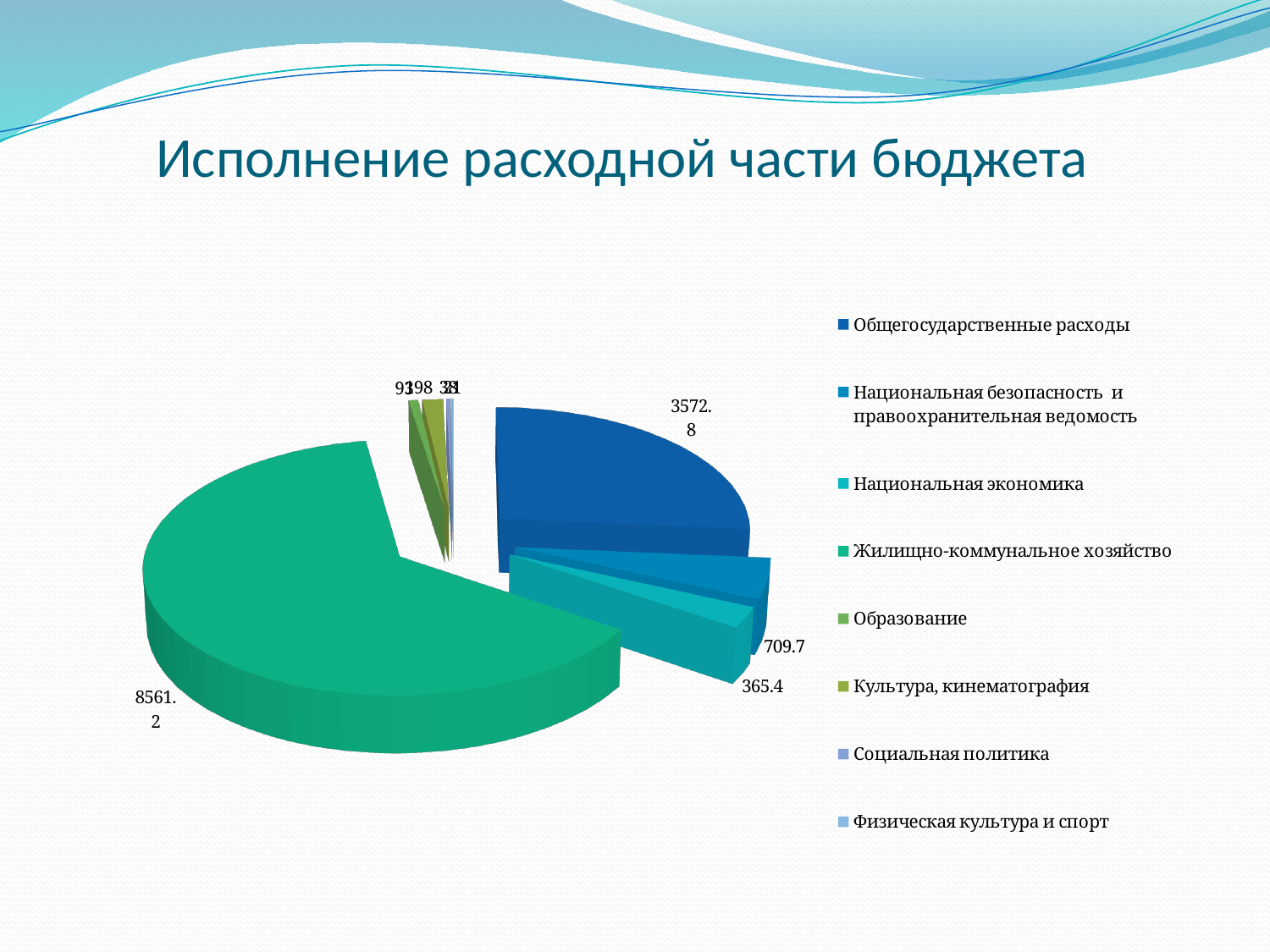
What is the difference between the values for Национальная безопасность и правоохранительная ведомость and Национальная экономика? 344.3 What is the difference between the values for Жилищно-коммунальное хозяйство and Общегосударственные расходы? 4988.4 How many categories does the legend list? 8 What is the value for Национальная экономика? 365.4 Which category has the largest slice of the pie? Жилищно-коммунальное хозяйство Which is larger, Общегосударственные расходы or Национальная безопасность и правоохранительная ведомость? Общегосударственные расходы What colour is the slice for Жилищно-коммунальное хозяйство? green What kind of chart is shown on the slide? pie chart What is the value for Национальная безопасность и правоохранительная ведомость? 709.7 What is the title of the chart? Исполнение расходной части бюджета What is the value for Общегосударственные расходы? 3572.8 What is the value for Жилищно-коммунальное хозяйство? 8561.2